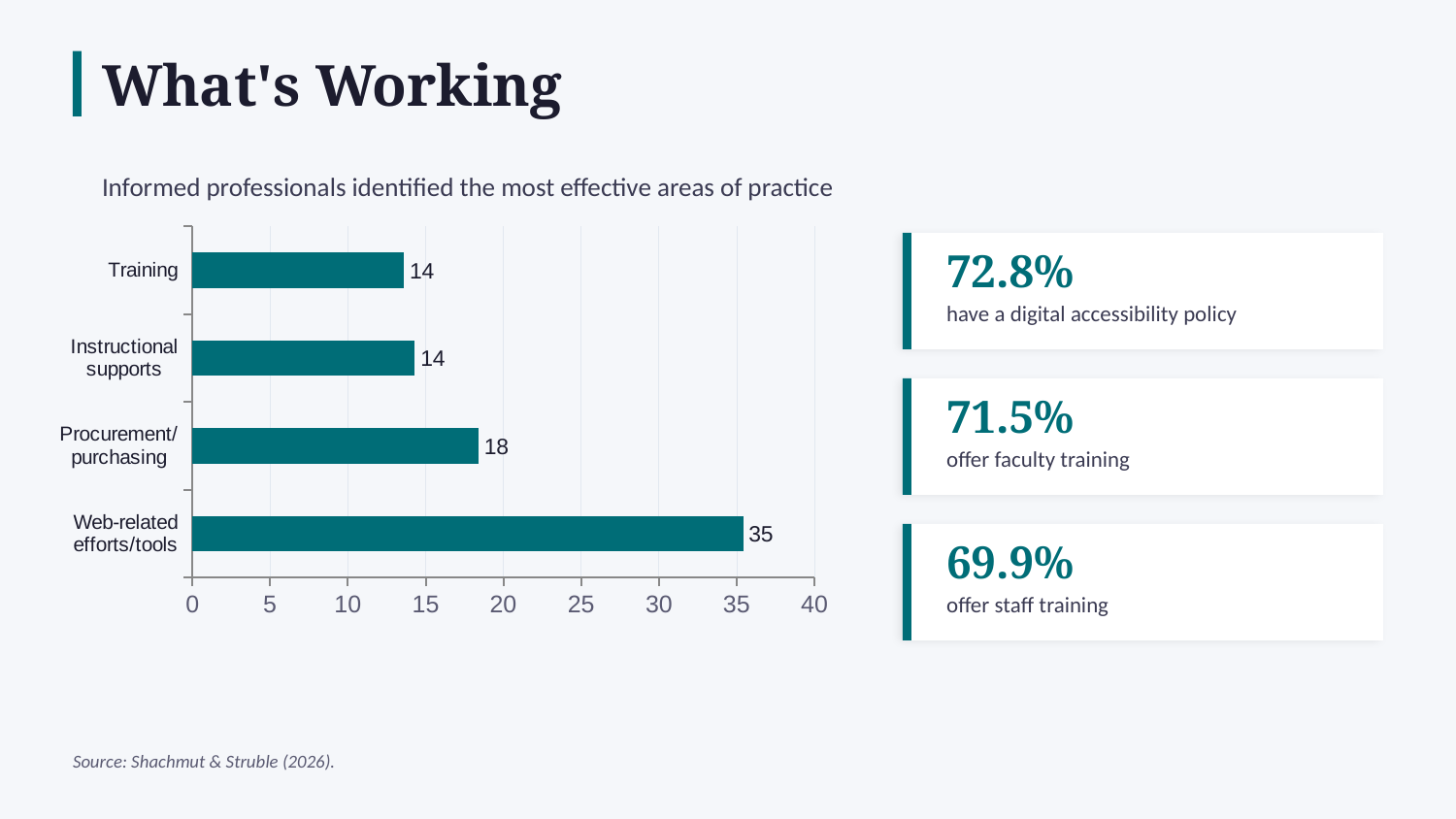
What is the value for Instructional supports? 14 How many categories are shown in the chart? 4 Which is larger, the value for Procurement/purchasing or the value for Instructional supports? Procurement/purchasing What is the value for Web-related efforts/tools? 35 What kind of chart is shown on the slide? Bar chart What is the difference between the values for Web-related efforts/tools and Procurement/purchasing? 17 What is the highest value shown on the horizontal axis of the chart? 40 Which category has the highest value? Web-related efforts/tools What is the difference between the values for Procurement/purchasing and Training? 4 What is the value for Training? 14 Is the value for Web-related efforts/tools greater or less than 30? greater What is the value for Procurement/purchasing? 18